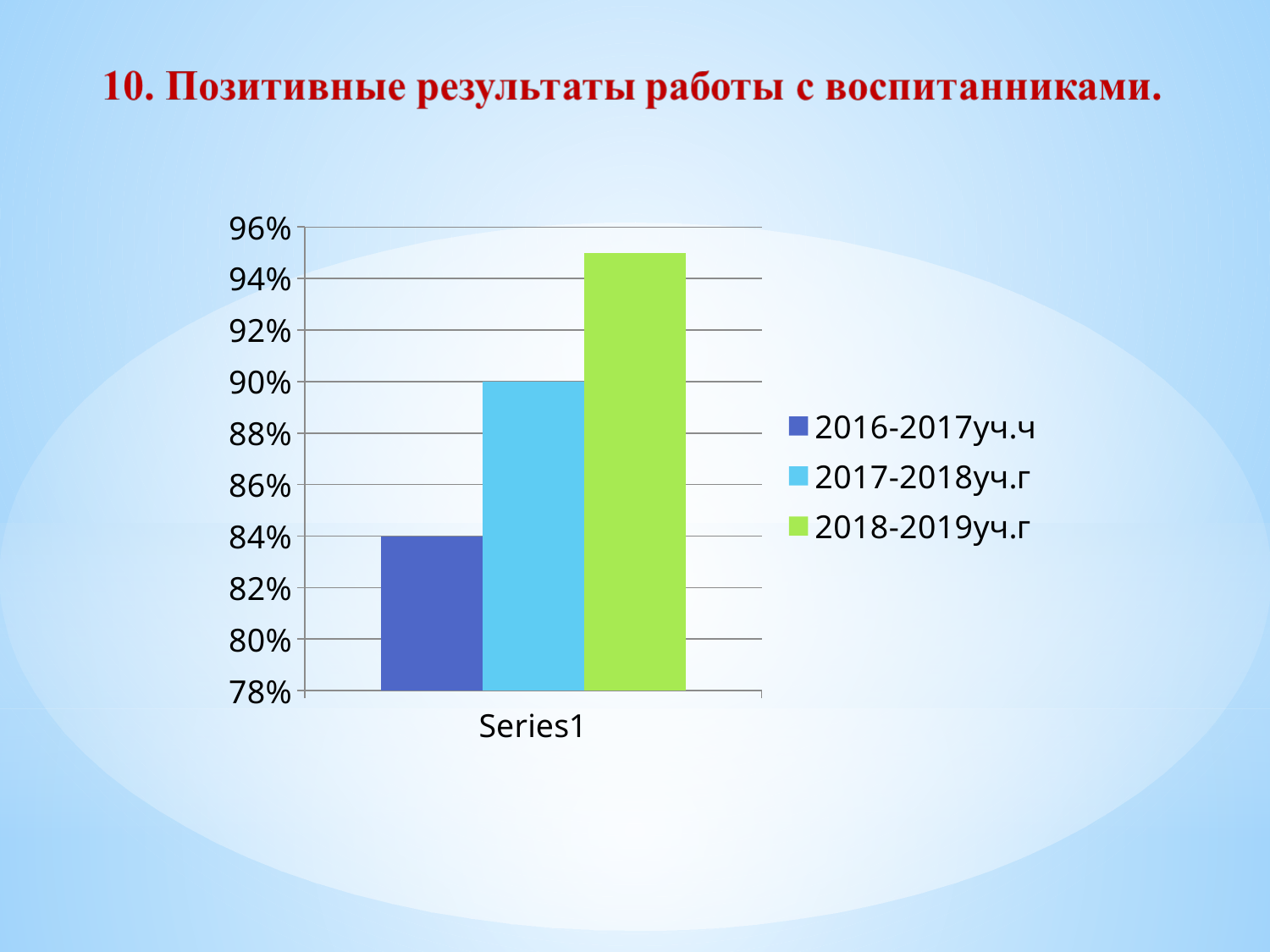
Which is larger, the value for 2017-2018уч.г or the value for 2016-2017уч.ч? 2017-2018уч.г What kind of chart is shown on the slide? bar chart What is the value for 2017-2018уч.г? 90% What is the difference between the values for 2017-2018уч.г and 2016-2017уч.ч? 6% Is the value for 2018-2019уч.г greater or less than 94%? greater Do the values rise or fall from 2016-2017уч.ч to 2018-2019уч.г? rise Which series has the highest value? 2018-2019уч.г Is the value for 2016-2017уч.ч greater or less than 86%? less How many series does the legend list? 3 What is the value for 2016-2017уч.ч? 84% Which series has the lowest value? 2016-2017уч.ч What colour is the bar for 2018-2019уч.г? green